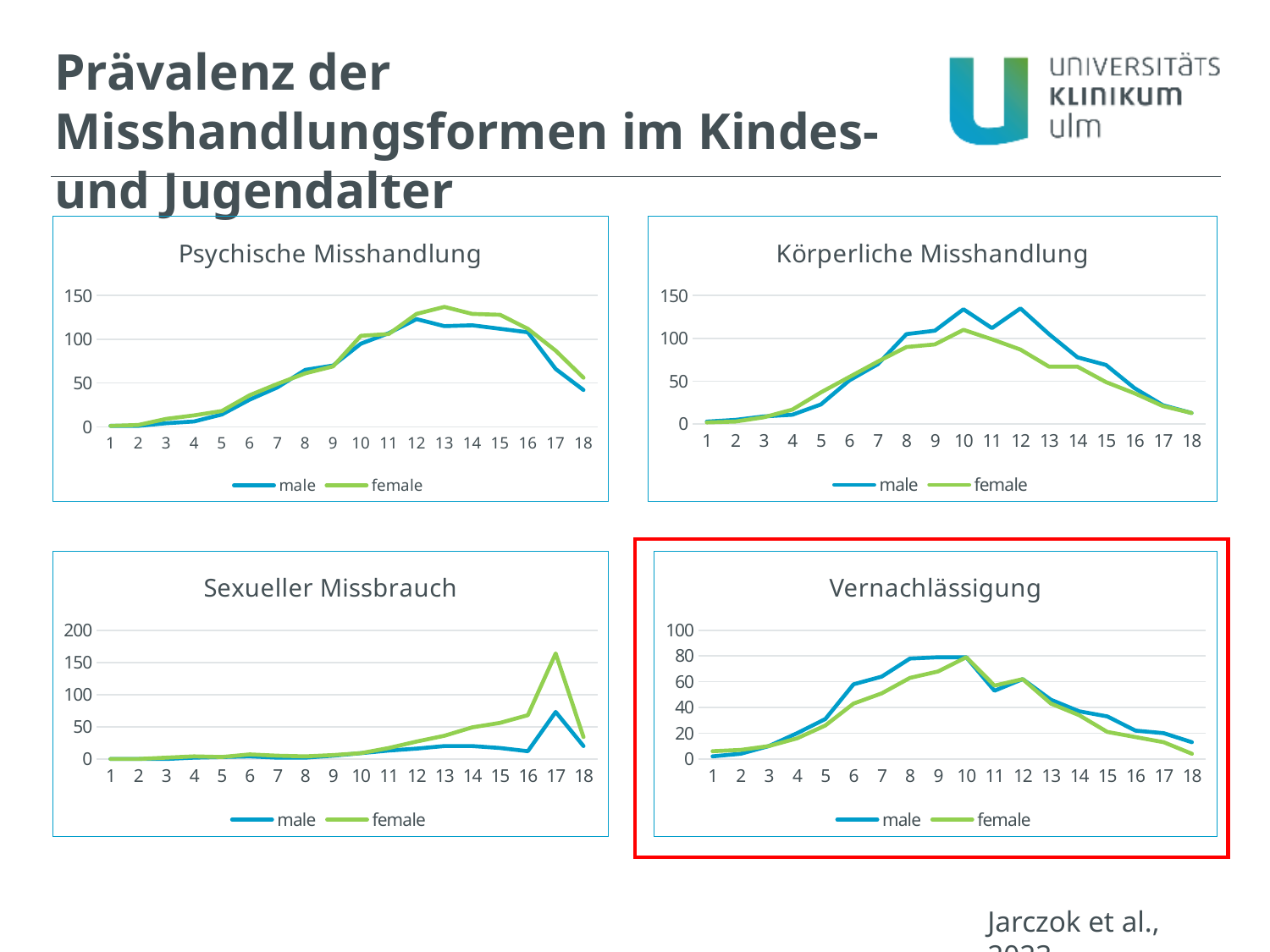
In the "Körperliche Misshandlung" chart, is the male value at age 10 greater or less than 100? greater In the "Sexueller Missbrauch" chart, is the female value at age 17 greater or less than 150? greater In the "Vernachlässigung" chart, is the male value at age 8 greater or less than 60? greater How many series does the legend of the "Körperliche Misshandlung" chart list? 2 In the "Sexueller Missbrauch" chart, which series has the larger value at age 17, male or female? female Which chart on the slide is highlighted with a red border? Vernachlässigung In the "Psychische Misshandlung" chart, does the male series rise or fall from age 16 to age 18? fall How many age categories are shown on the x axis of the "Vernachlässigung" chart? 18 What kind of chart is the "Psychische Misshandlung" chart? line chart In the "Sexueller Missbrauch" chart, at which age does the female series reach its highest value? 17 In the "Körperliche Misshandlung" chart, which series has the larger value at age 12, male or female? male